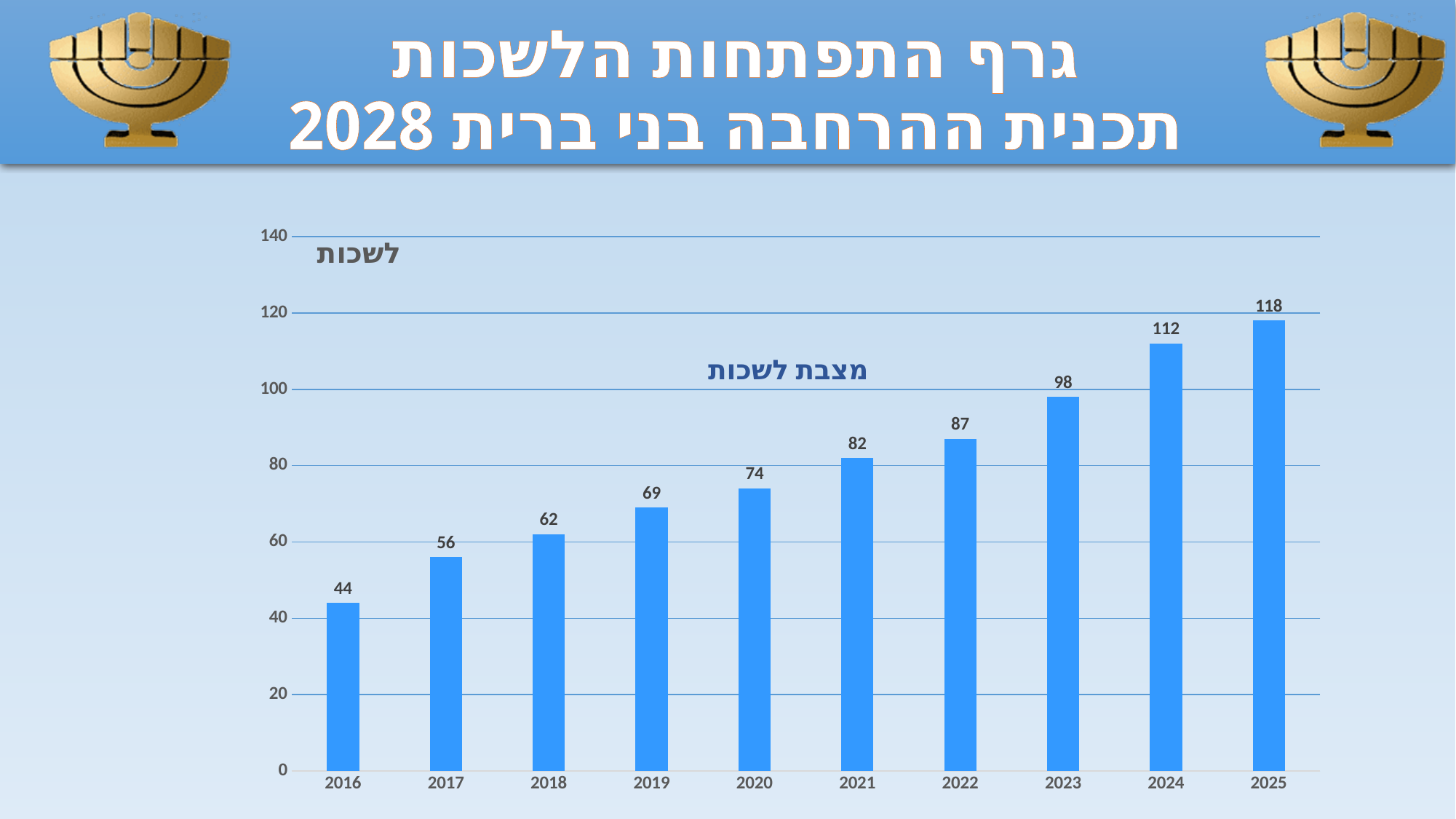
What is the value for 2016? 44 What is the difference between the values for 2022 and 2021? 5 Do the values rise or fall from 2016 to 2025? rise What is the value for 2020? 74 How many years are shown on the x axis? 10 What is the value for 2023? 98 Is the value for 2024 greater or less than 100? greater What kind of chart is shown on the slide? bar chart What is the difference between the values for 2025 and 2016? 74 Which year has the highest value? 2025 Which year has the lowest value? 2016 Which is larger, the value for 2019 or the value for 2018? 2019